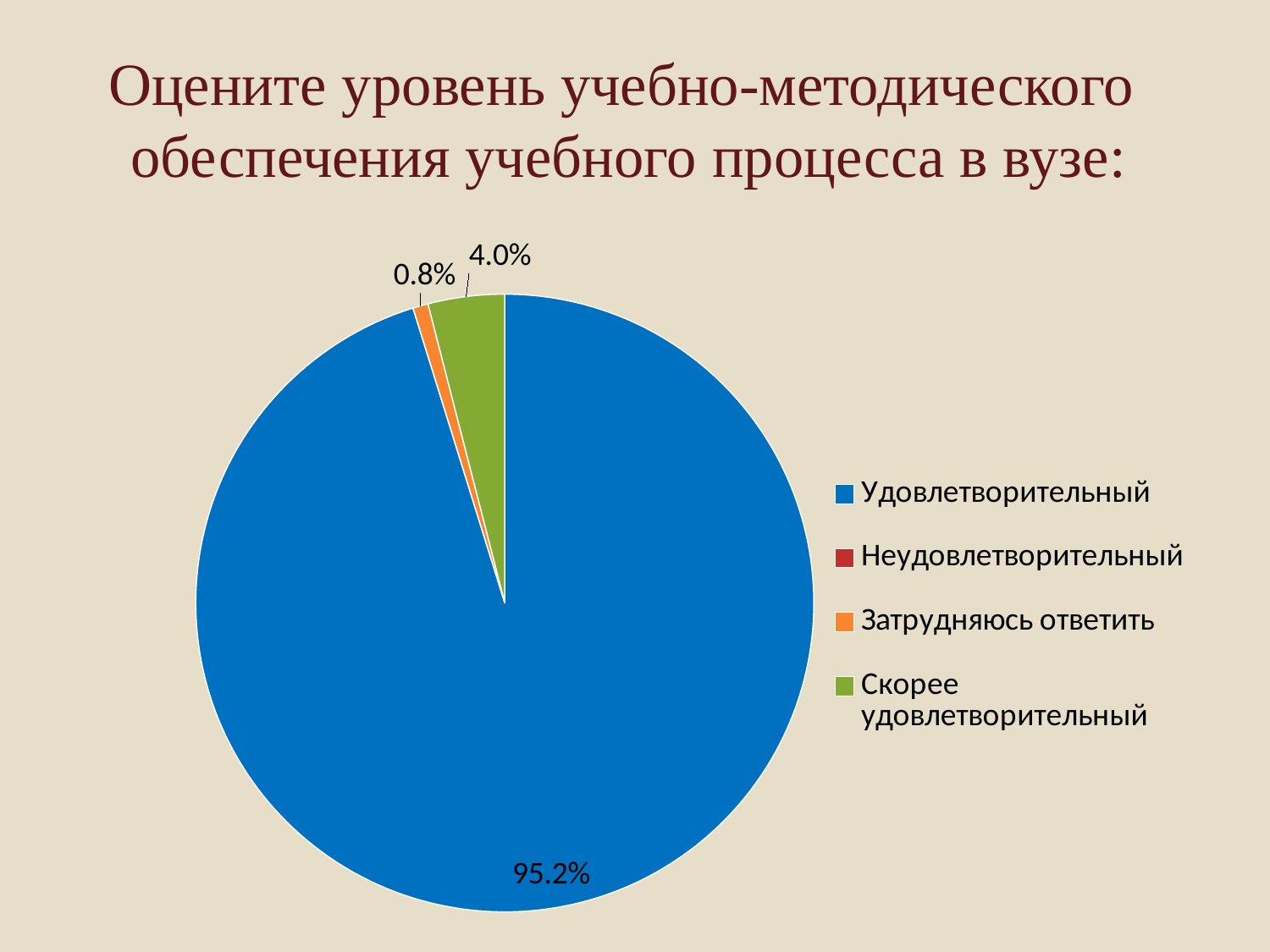
What kind of chart is shown on the slide? Pie chart How many entries does the legend list? 4 What colour is the slice for "Удовлетворительный"? Blue Which category has the largest slice of the pie? Удовлетворительный What is the difference between the shares of "Скорее удовлетворительный" and "Затрудняюсь ответить"? 3.2% What share of the pie does "Удовлетворительный" have? 95.2% What share of the pie does "Затрудняюсь ответить" have? 0.8% What share of the pie does "Скорее удовлетворительный" have? 4.0% What colour is the slice for "Скорее удовлетворительный"? Green What is the difference between the shares of "Удовлетворительный" and "Скорее удовлетворительный"? 91.2% Which of the labelled slices is the smallest? Затрудняюсь ответить Which is larger: the share for "Скорее удовлетворительный" or the share for "Затрудняюсь ответить"? Скорее удовлетворительный